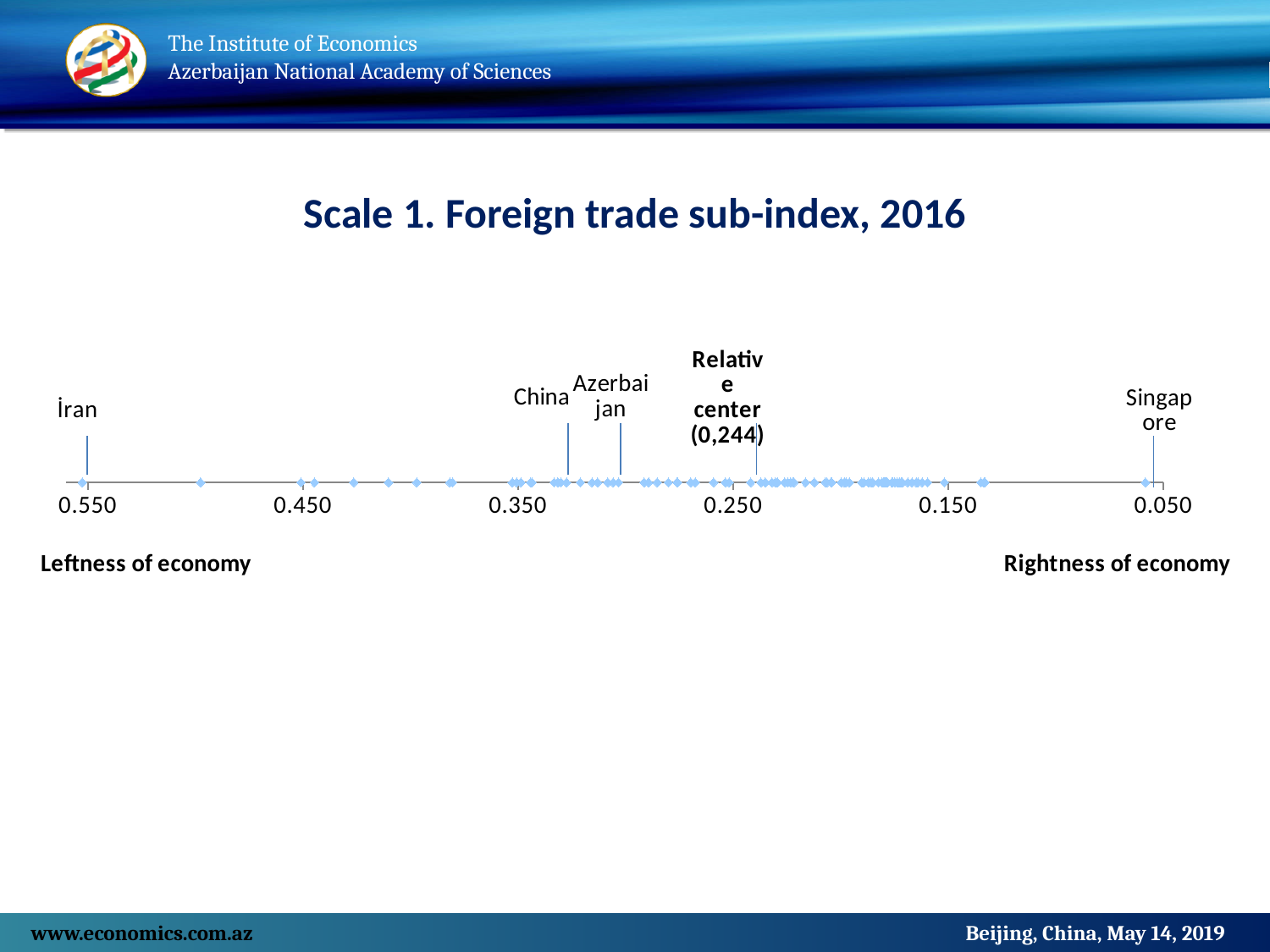
Do the axis tick values increase or decrease from left to right along the scale? decrease Which of the labeled countries has the lowest foreign trade sub-index value? Singapore What value is printed for the Relative center on the chart? 0,244 Which has the larger value, China or Azerbaijan? China What is the title of the chart on the slide? Scale 1. Foreign trade sub-index, 2016 Is the value for Azerbaijan greater or less than 0.250? greater How many countries are labeled by name on the chart? 4 Is the value for Iran greater or less than 0.450? greater Which of the labeled countries has the highest foreign trade sub-index value? Iran What label appears at the right end of the scale below the axis? Rightness of economy Is the value for Singapore greater or less than 0.150? less